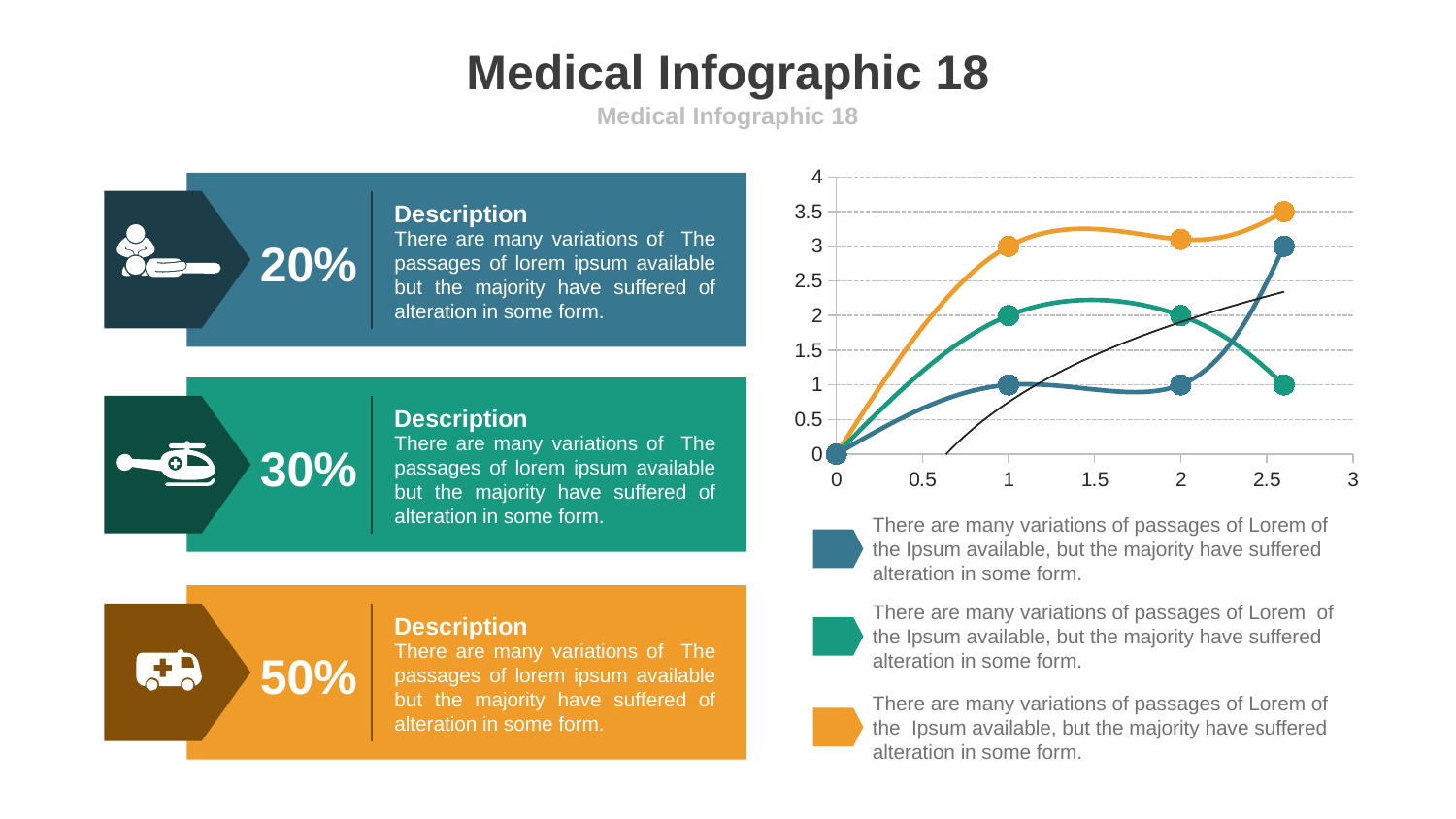
At the last plotted point (x ≈ 2.6), which series is higher: the orange series or the green series? orange Is the y value of the green series at x = 2 greater or less than 3? less In the chart, what is the y value of the blue series at its last point (x ≈ 2.6)? 3 In the chart, what is the y value of the green series at its last point (x ≈ 2.6)? 1 In the chart, what is the y value of the orange series at its last point (x ≈ 2.6)? 3.5 In the chart, what is the y value of the orange series at x = 1? 3 Does the blue series rise or fall between x = 2 and its last point? rise What is the maximum value shown on the chart's y axis? 4 What kind of chart is shown on the right side of the slide? line chart In the chart, what is the y value of the blue series at x = 1? 1 Which coloured series reaches the highest y value in the chart? orange Is the y value of the orange series at x = 2 greater or less than 2? greater